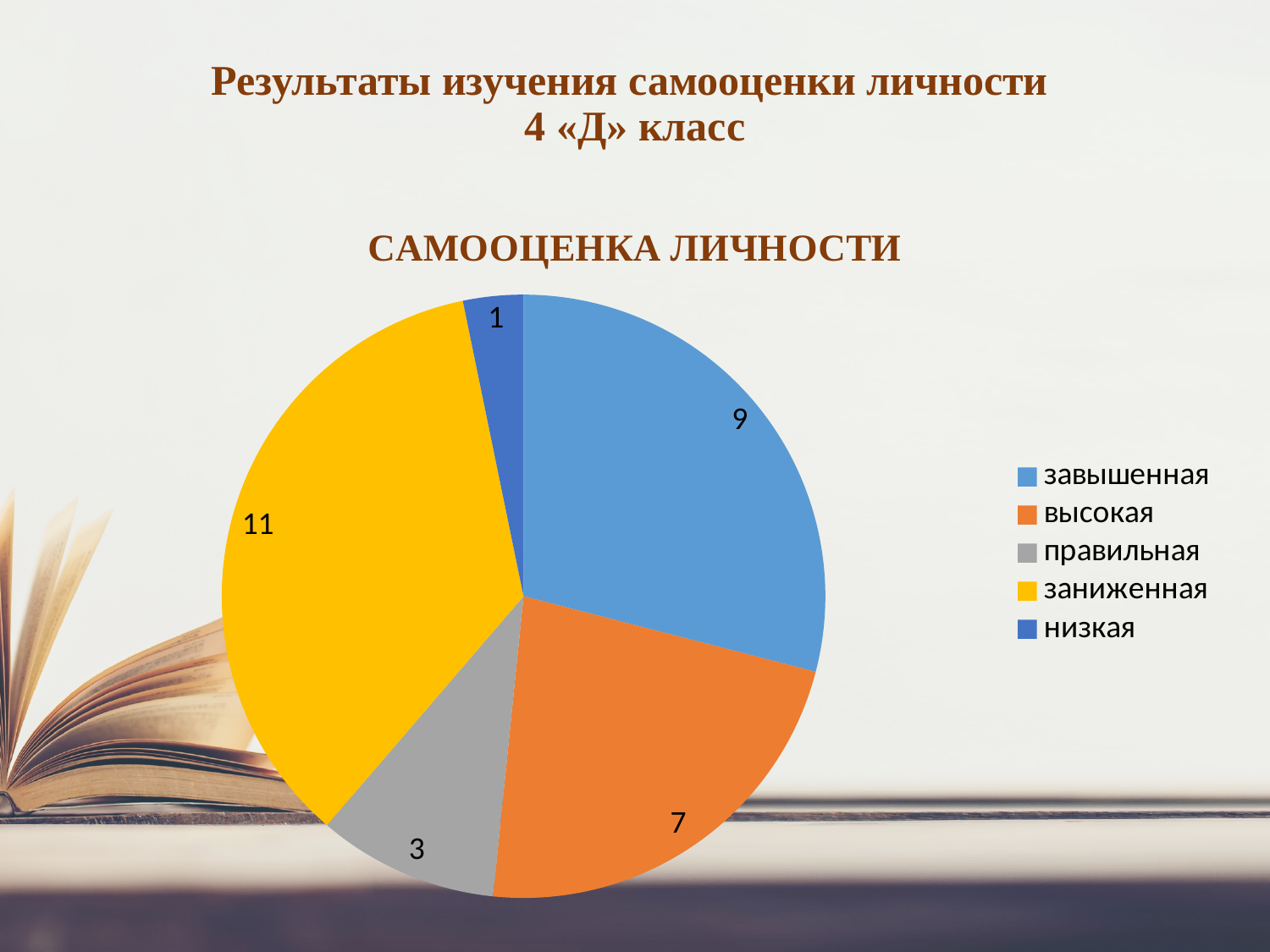
What type of chart is shown on the slide? pie chart What is the value for низкая in the pie chart? 1 Which category has the smallest slice in the pie chart? низкая What is the value for заниженная in the pie chart? 11 Which is larger, the value for высокая or the value for правильная? высокая Which category has the largest slice in the pie chart? заниженная What is the value for высокая in the pie chart? 7 What is the value for правильная in the pie chart? 3 What is the difference between the values for заниженная and завышенная? 2 What is the value for завышенная in the pie chart? 9 How many categories does the pie chart have? 5 What is the title of the chart? САМООЦЕНКА ЛИЧНОСТИ